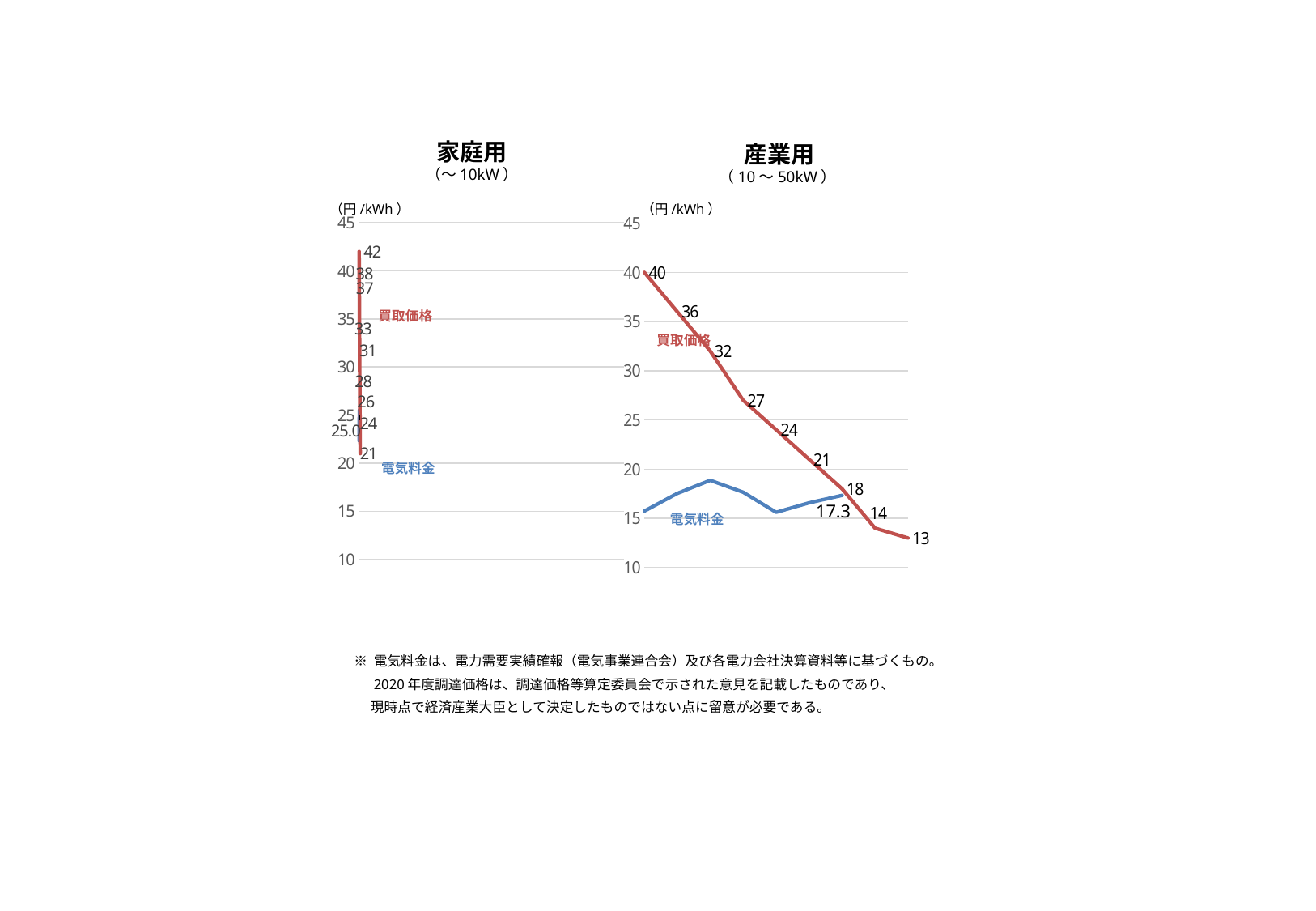
In the 産業用 chart on the right, does the 買取価格 line rise or fall from left to right? fall In the 産業用 chart on the right, which is larger at the right end: the 買取価格 value of 13 or the 電気料金 value of 17.3? 電気料金 (17.3) In the 産業用 chart on the right, what is the lowest labeled value of the 買取価格 line? 13 In the 産業用 chart on the right, what value is labeled on the 電気料金 line? 17.3 In the 産業用 chart on the right, what is the difference between the first (40) and last (13) labeled values of the 買取価格 line? 27 In the 産業用 chart on the right, what is the first labeled value of the 買取価格 line? 40 In the 産業用 chart on the right, what is the highest labeled value of the 買取価格 line? 40 In the 家庭用 chart on the left, what is the highest labeled value of the 買取価格 line? 42 In the 産業用 chart on the right, what is the last labeled value of the 買取価格 line? 13 In the 産業用 chart on the right, is the 電気料金 line ever greater or less than 20? less In the 家庭用 chart on the left, what is the lowest labeled value of the 買取価格 line? 21 What kind of chart is the 産業用 chart on the right? line chart